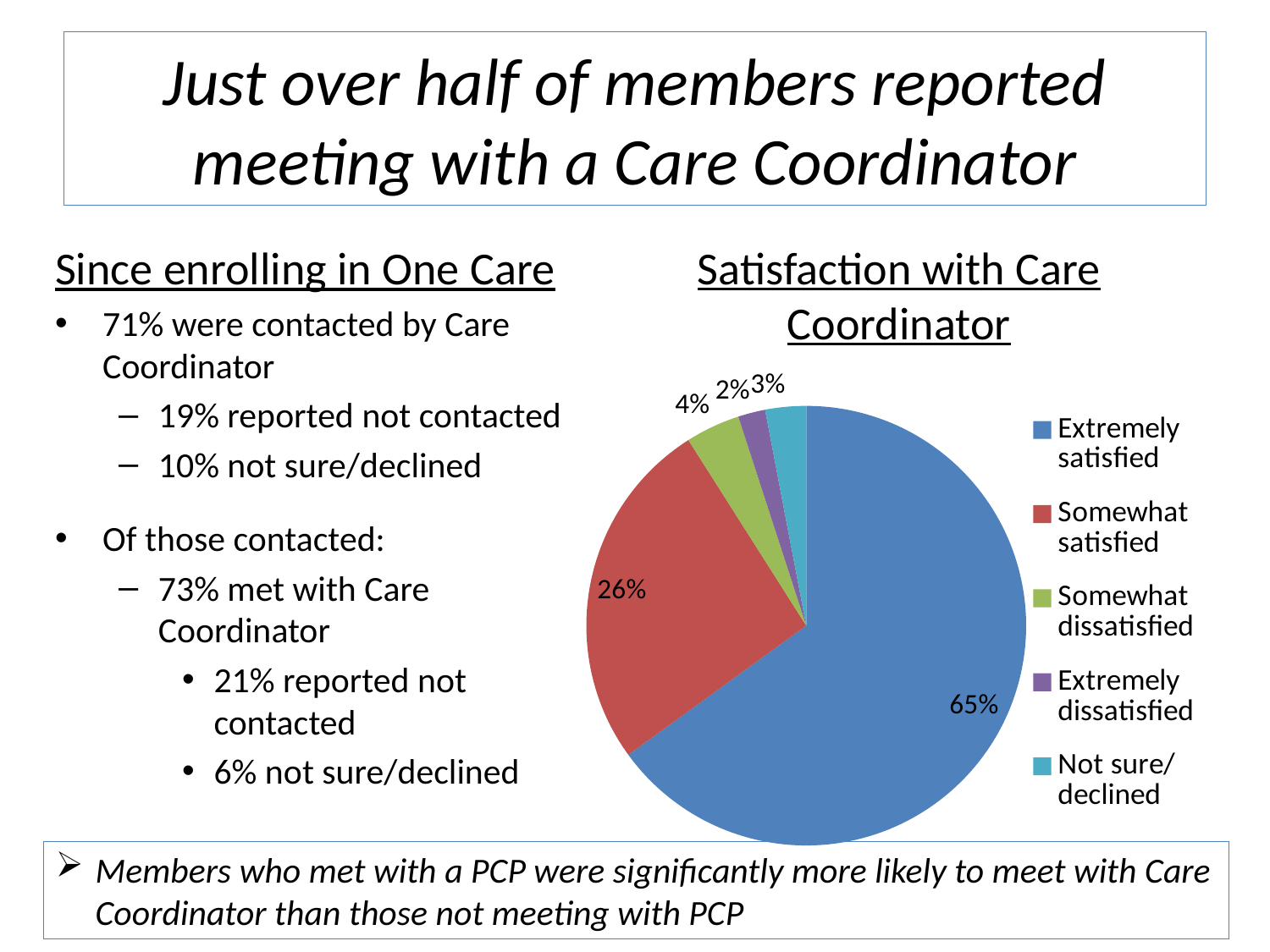
What percentage of members were Somewhat satisfied with their Care Coordinator? 26% Which is larger, the Somewhat dissatisfied slice or the Not sure/declined slice? Somewhat dissatisfied How many percentage points larger is the Extremely satisfied slice than the Somewhat satisfied slice? 39 What share of the pie is labelled Extremely satisfied? 65% What percentage of members were Extremely dissatisfied with their Care Coordinator? 2% What percentage of members were Somewhat dissatisfied with their Care Coordinator? 4% Which category has the smallest slice of the pie? Extremely dissatisfied How many categories does the pie chart show? 5 What kind of chart is shown on the slide? Pie chart What percentage of members answered Not sure/declined about satisfaction with their Care Coordinator? 3% What is the title of the chart? Satisfaction with Care Coordinator Which category has the largest slice of the pie? Extremely satisfied